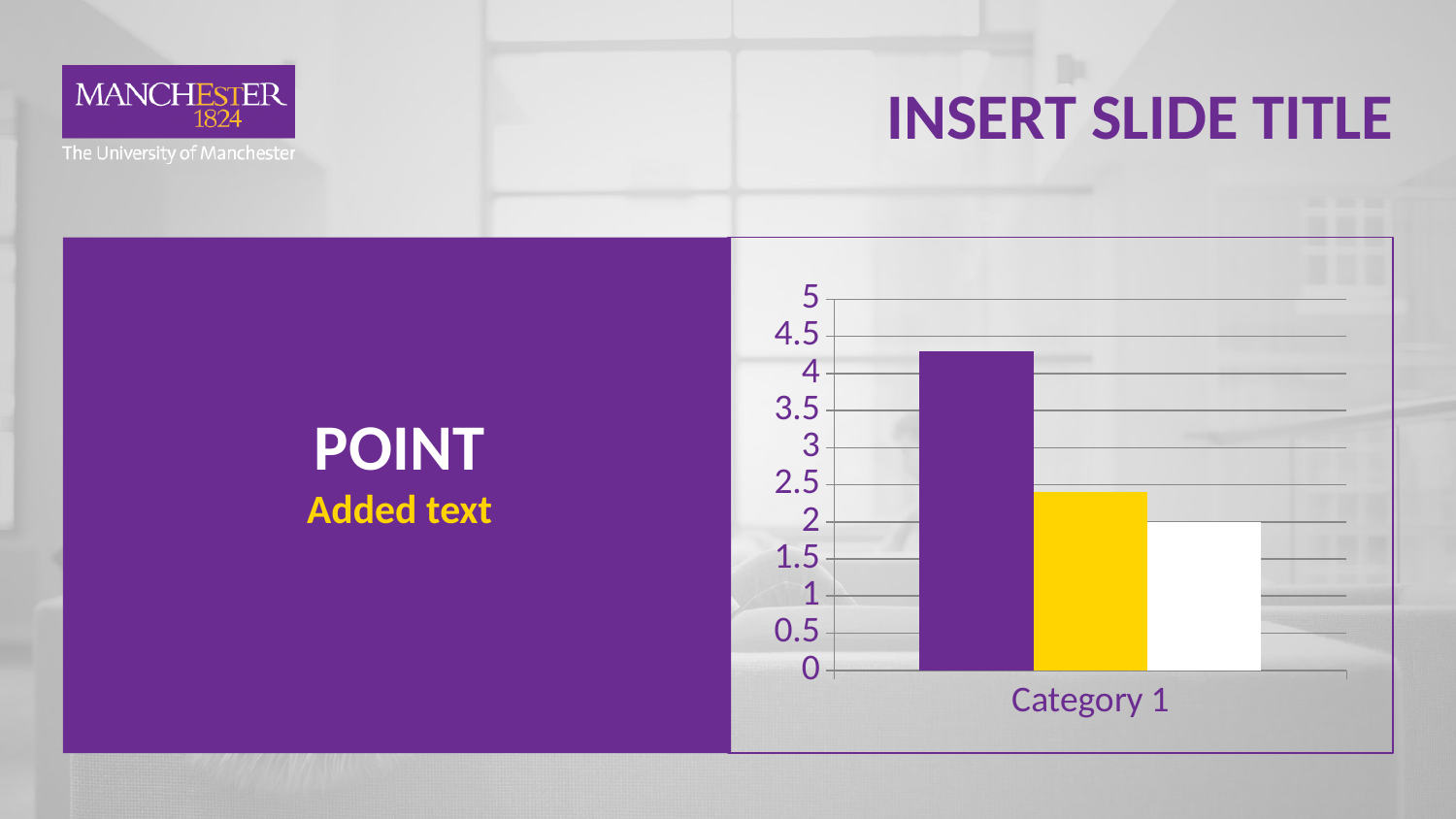
Which bar is the shortest in the chart? The white bar How many bars are plotted in the chart? 3 What kind of chart is shown on the slide? Bar chart Which is larger, the purple bar or the yellow bar? The purple bar How many categories are shown on the x axis of the chart? 1 Is the value of the purple bar greater or less than 4.5? less What is the highest value shown on the y axis of the chart? 5 What is the label of the category on the x axis? Category 1 Is the value of the yellow bar greater or less than 2? greater Which bar is the tallest in the chart? The purple bar Is the value of the purple bar greater or less than 4? greater